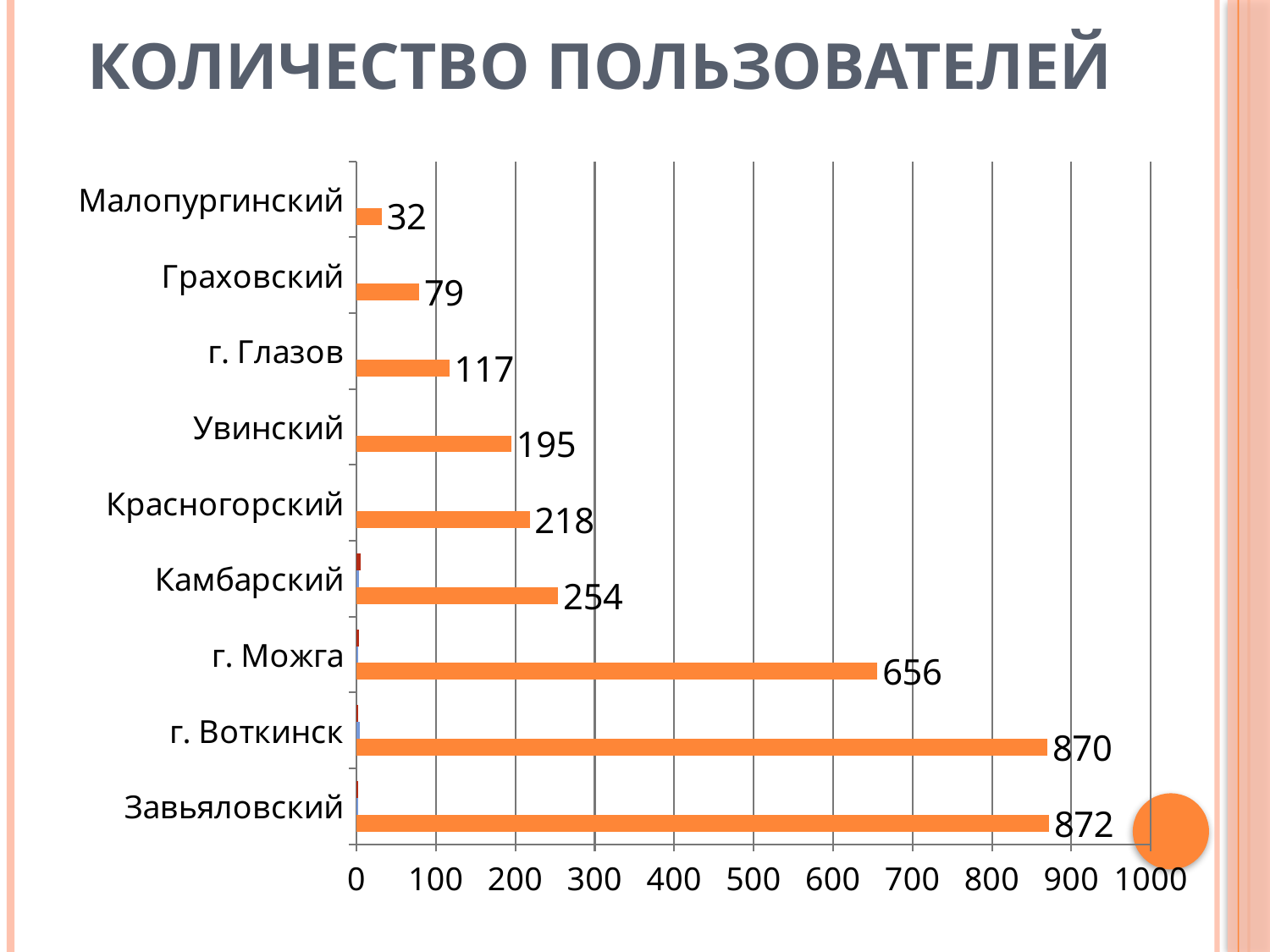
What is the value for Граховский? 79 What is the difference between the values for Камбарский and Красногорский? 36 How many categories are shown in the chart? 9 What is the value for Увинский? 195 Which is larger, the value for г. Глазов or the value for Увинский? Увинский What is the difference between the values for г. Воткинск and г. Можга? 214 Which category has the highest value? Завьяловский What is the value for г. Можга? 656 Is the value for Камбарский greater or less than 300? less Which category has the lowest value? Малопургинский What kind of chart is shown on the slide? bar chart What is the title of the slide? КОЛИЧЕСТВО ПОЛЬЗОВАТЕЛЕЙ